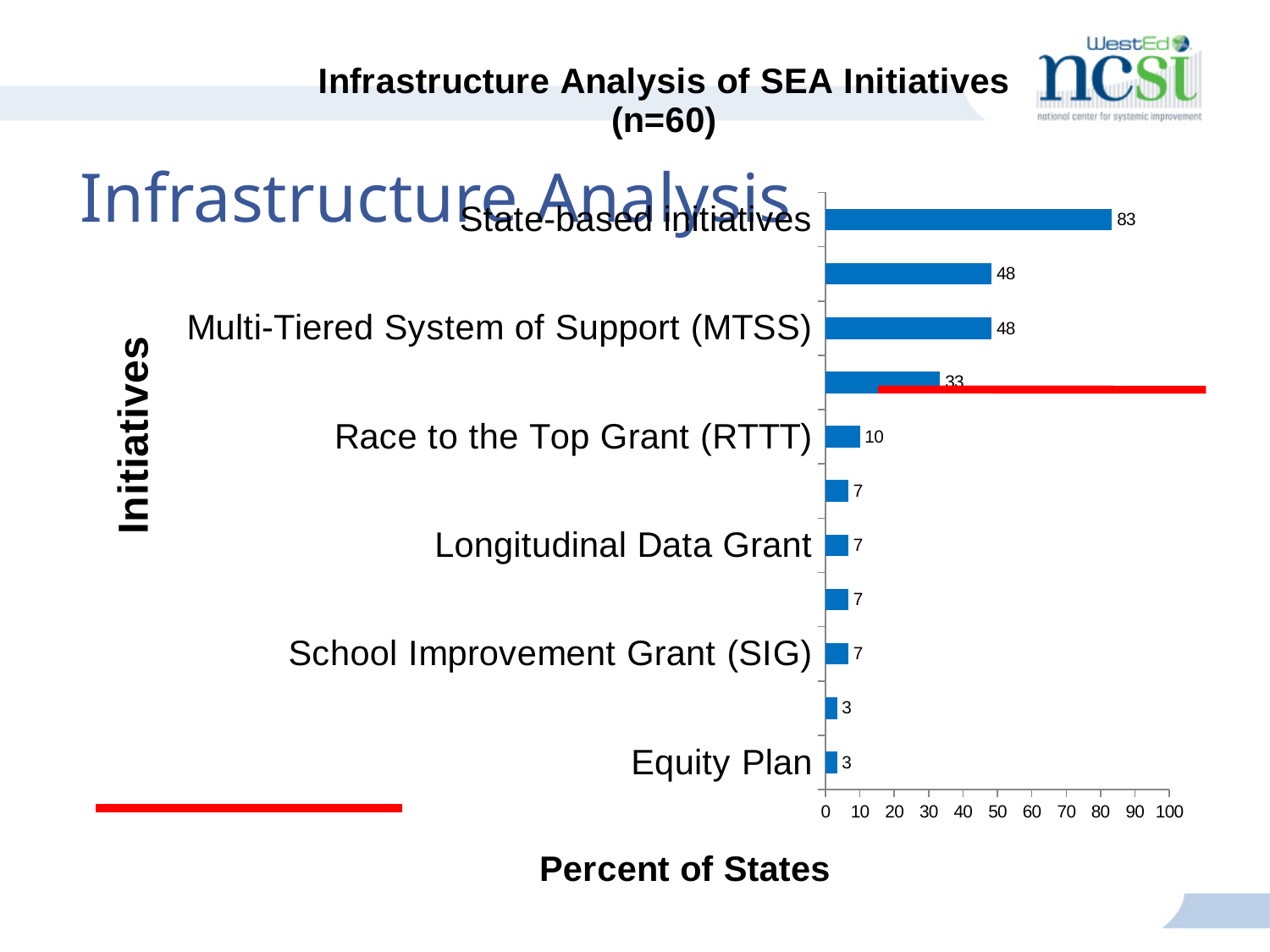
How many bars are plotted in the chart? 11 What percent of states is shown for Multi-Tiered System of Support (MTSS)? 48 What is the value for Longitudinal Data Grant? 7 What is the value for State-based initiatives? 83 What is the difference between the values for State-based initiatives and Multi-Tiered System of Support (MTSS)? 35 Which initiative has the highest percent of states? State-based initiatives What is the value for School Improvement Grant (SIG)? 7 What kind of chart is shown on the slide? Bar chart What is the value for Equity Plan? 3 What is the value for Race to the Top Grant (RTTT)? 10 What is the title of the horizontal axis? Percent of States Which has a larger value, Multi-Tiered System of Support (MTSS) or Race to the Top Grant (RTTT)? Multi-Tiered System of Support (MTSS)